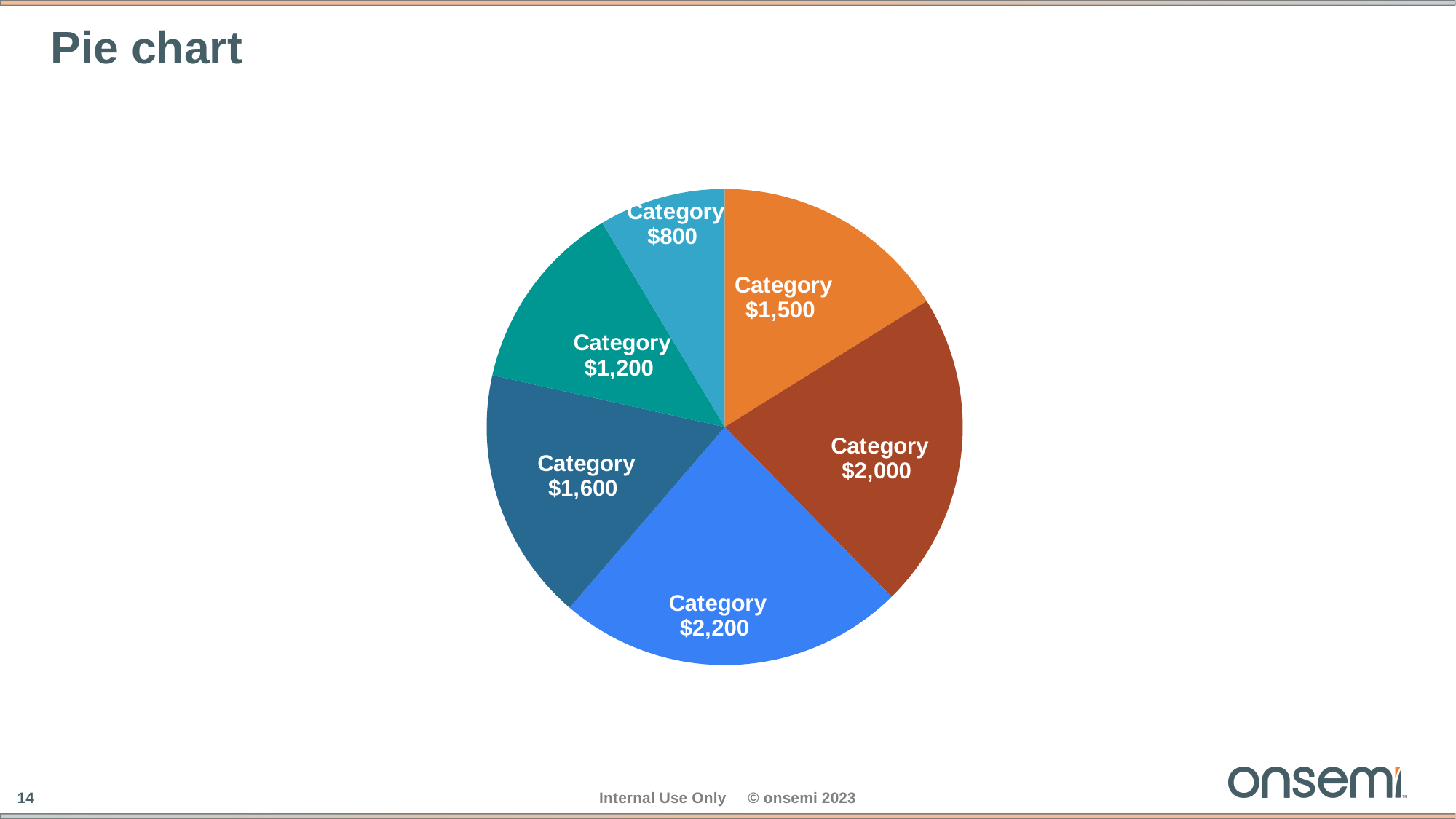
What is the title of the slide? Pie chart What is the difference between the $1,600 slice and the $1,200 slice? $400 What value is labelled on the orange slice of the pie chart? $1,500 Which slice is larger, the orange slice or the teal slice? the orange slice ($1,500) What is the total of all the slice values in the pie chart? $9,300 How many slices does the pie chart have? 6 What is the difference between the $2,200 slice and the $2,000 slice? $200 What kind of chart is shown on the slide? pie chart What value is labelled on the light blue slice at the top of the pie chart? $800 What is the value of the smallest slice in the pie chart? $800 What value is labelled on the dark rust-brown slice on the right of the pie chart? $2,000 What is the value of the largest slice in the pie chart? $2,200